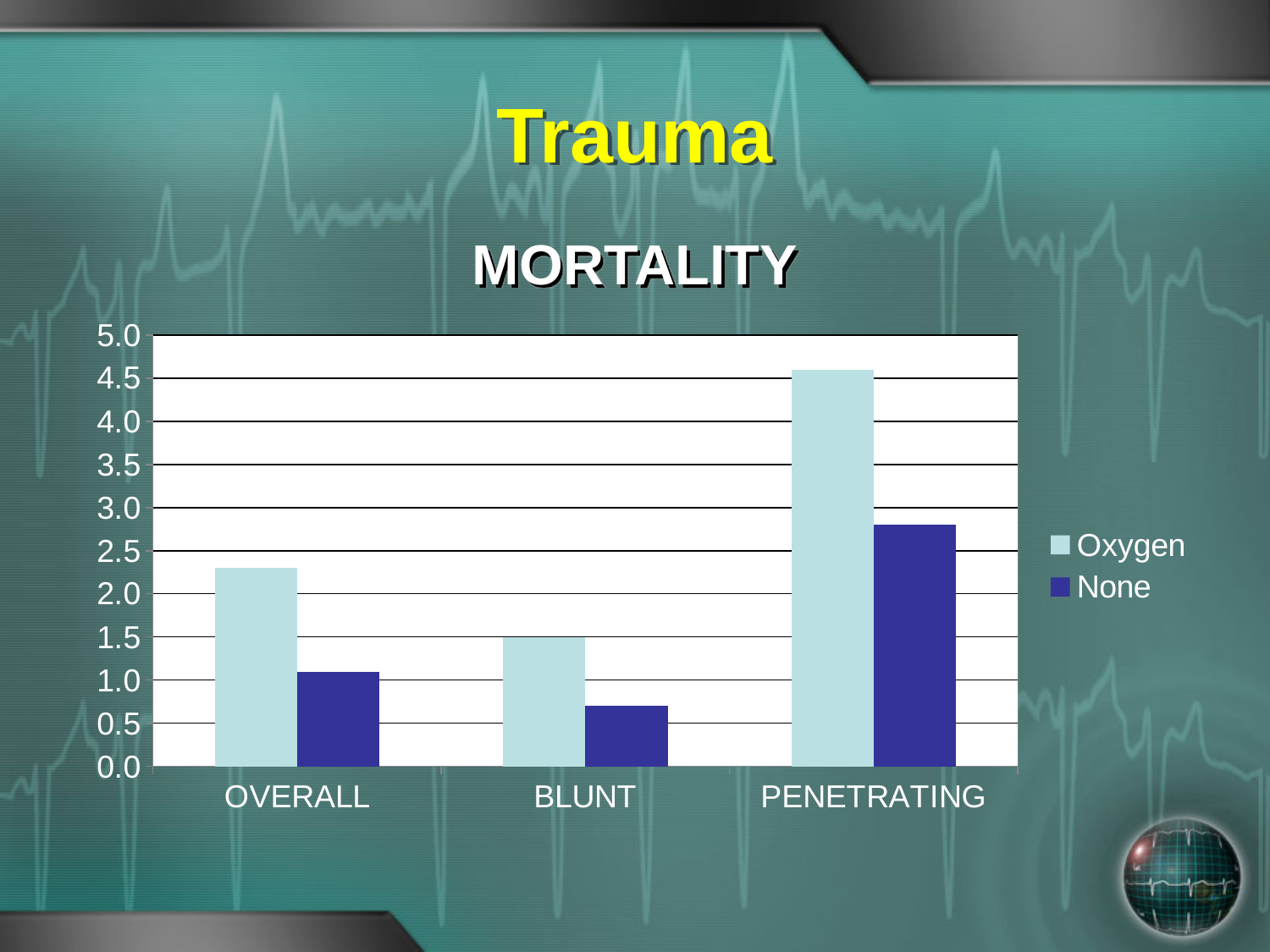
Is the None value for BLUNT greater or less than 1.0? less How many categories are shown on the x axis of the chart? 3 Is the Oxygen value for OVERALL greater or less than 2.0? greater In every category, which series has the taller bar, Oxygen or None? Oxygen Is the Oxygen value for PENETRATING greater or less than 4.0? greater Which category has the lowest None bar? BLUNT Which category has the highest Oxygen bar? PENETRATING What kind of chart is shown on the slide? bar chart Which is larger, the Oxygen value for OVERALL or the Oxygen value for BLUNT? OVERALL How many series does the chart's legend list? 2 What is the title of the chart? MORTALITY